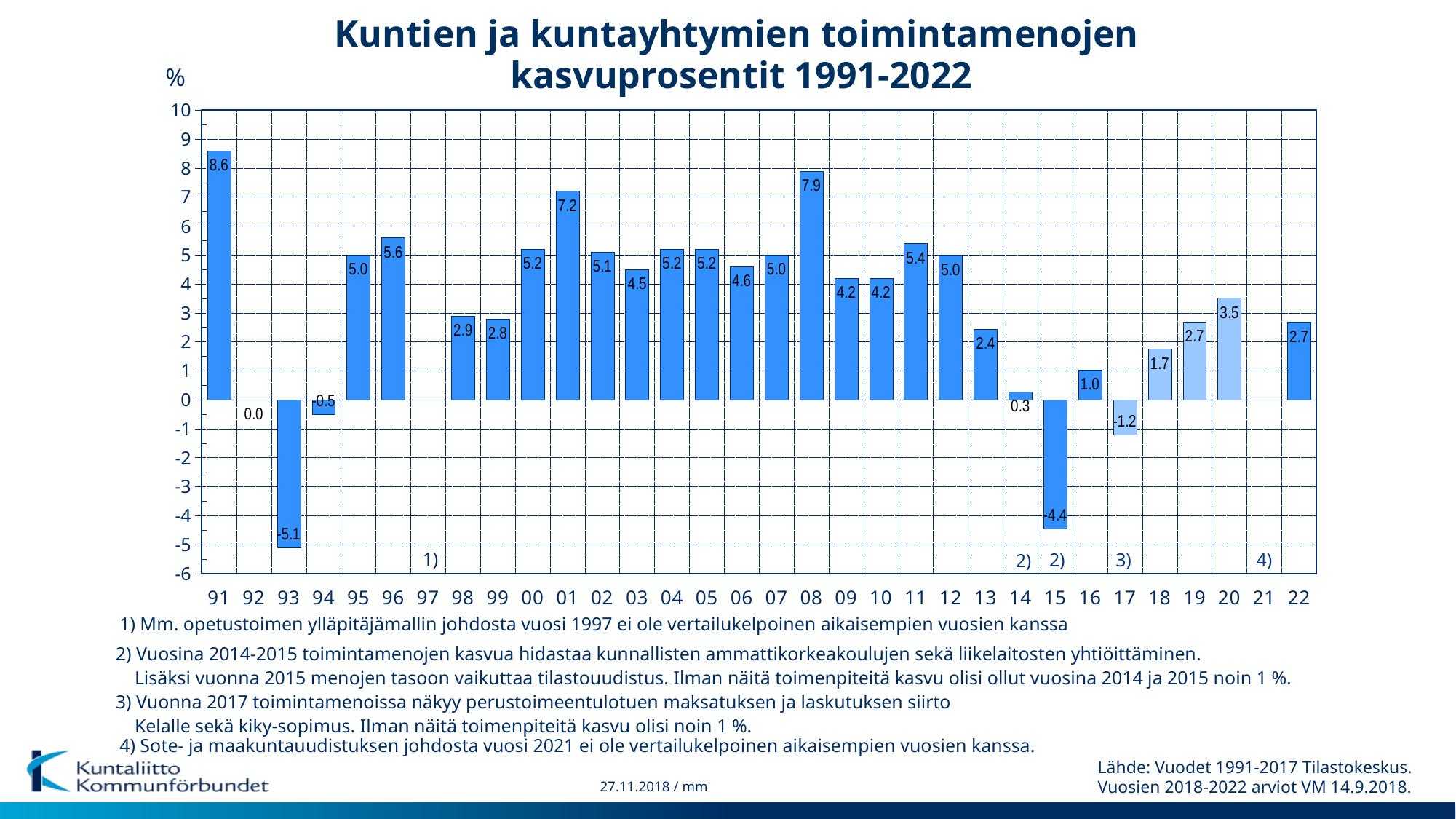
What is the difference between the values for 2008 (08) and 2009 (09)? 3.7 Which year has the highest growth percentage? 1991 (91) What value is shown for 2020 (20)? 3.5 What kind of chart is shown on the slide? Bar chart What value is shown for 2017 (17)? -1.2 What is the growth percentage shown for 2008 (08)? 7.9 Which year has the lowest growth percentage? 1993 (93) What value is shown for 2015 (15)? -4.4 What is the difference between the values for 2001 (01) and 2000 (00)? 2.0 Do the values rise or fall from 2018 (18) to 2020 (20)? Rise Which year has the larger value, 1995 (95) or 1996 (96)? 1996 (96) How many years are labelled on the x axis? 32